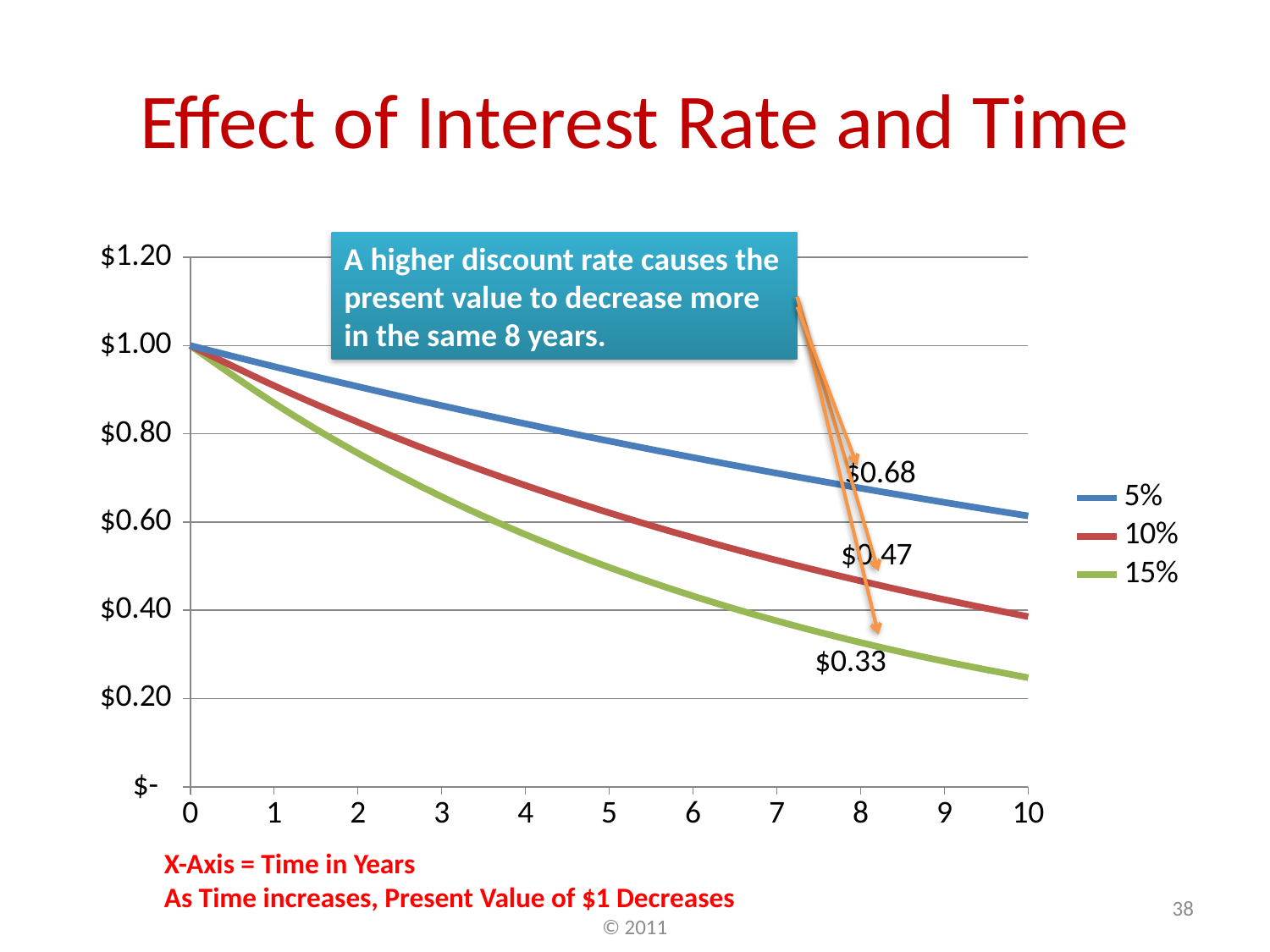
Which series has the lowest value at year 8? 15% At year 8, which series has the higher value, 10% or 15%? 10% At year 8, what is the difference between the 5% and 15% series values? $0.35 What kind of chart is shown on the slide? line chart What is the present value for the 10% series at year 8? $0.47 What is the present value for the 15% series at year 8? $0.33 What is the present value for the 5% series at year 8? $0.68 Is the value for the 5% series at year 2 greater or less than $0.80? greater How many series does the legend list? 3 Is the value for the 15% series at year 10 greater or less than $0.40? less At year 8, what is the difference between the 5% and 10% series values? $0.21 Do the values rise or fall as time in years increases? fall